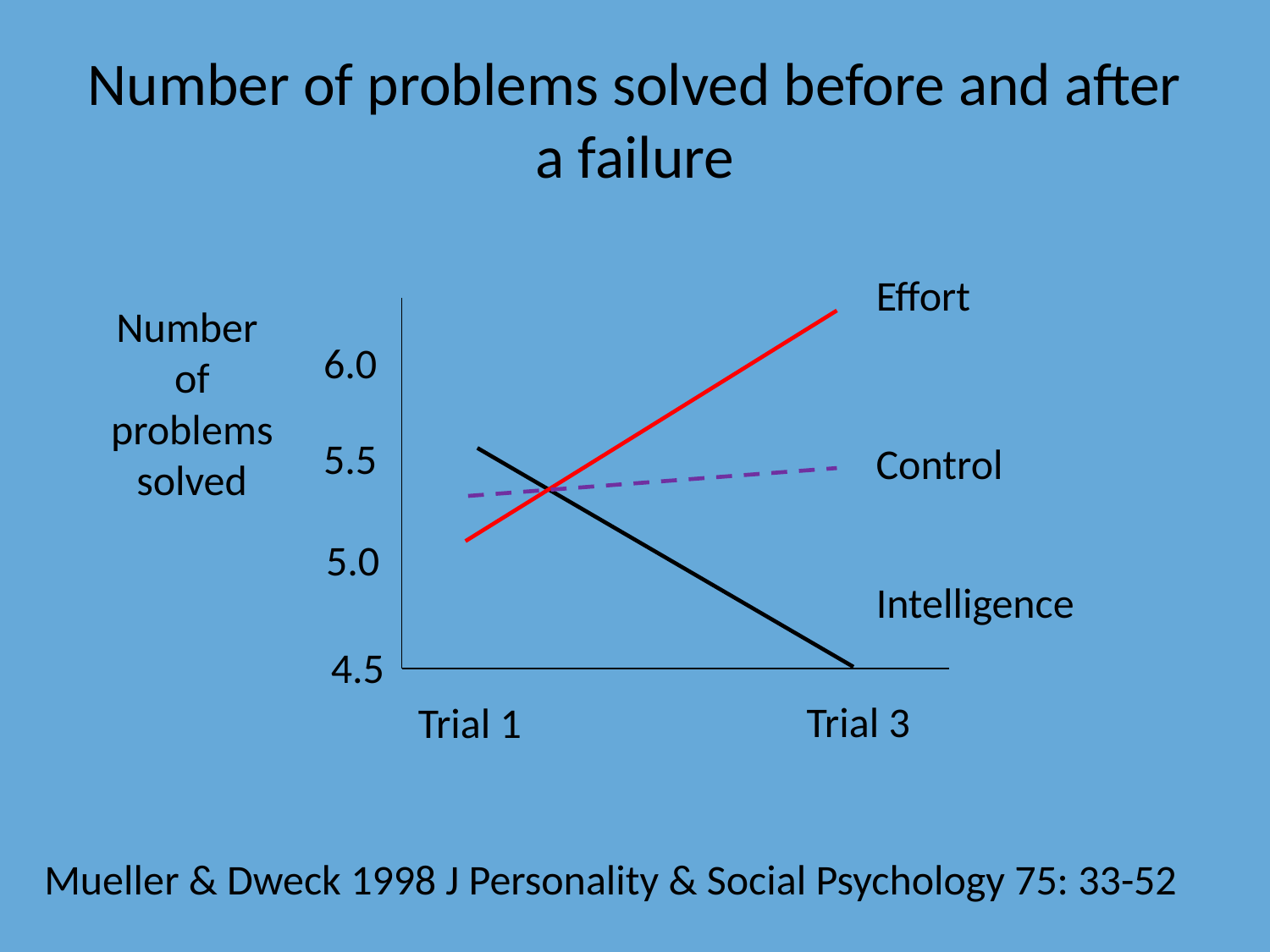
How many trials are labelled on the x axis? 2 Is the value for Control at Trial 1 greater or less than 5.5? less What kind of chart is shown on the slide? line chart Which group has the highest number of problems solved at Trial 3? Effort Is the value for Effort at Trial 3 greater or less than 6.0? greater Does the Control line rise or fall from Trial 1 to Trial 3? rise Does the Intelligence line rise or fall from Trial 1 to Trial 3? fall Which group has the lowest number of problems solved at Trial 3? Intelligence Which line on the chart is dashed? Control Is the value for Intelligence at Trial 3 greater or less than 5.0? less How many lines (series) are plotted on the chart? 3 Does the Effort line rise or fall from Trial 1 to Trial 3? rise